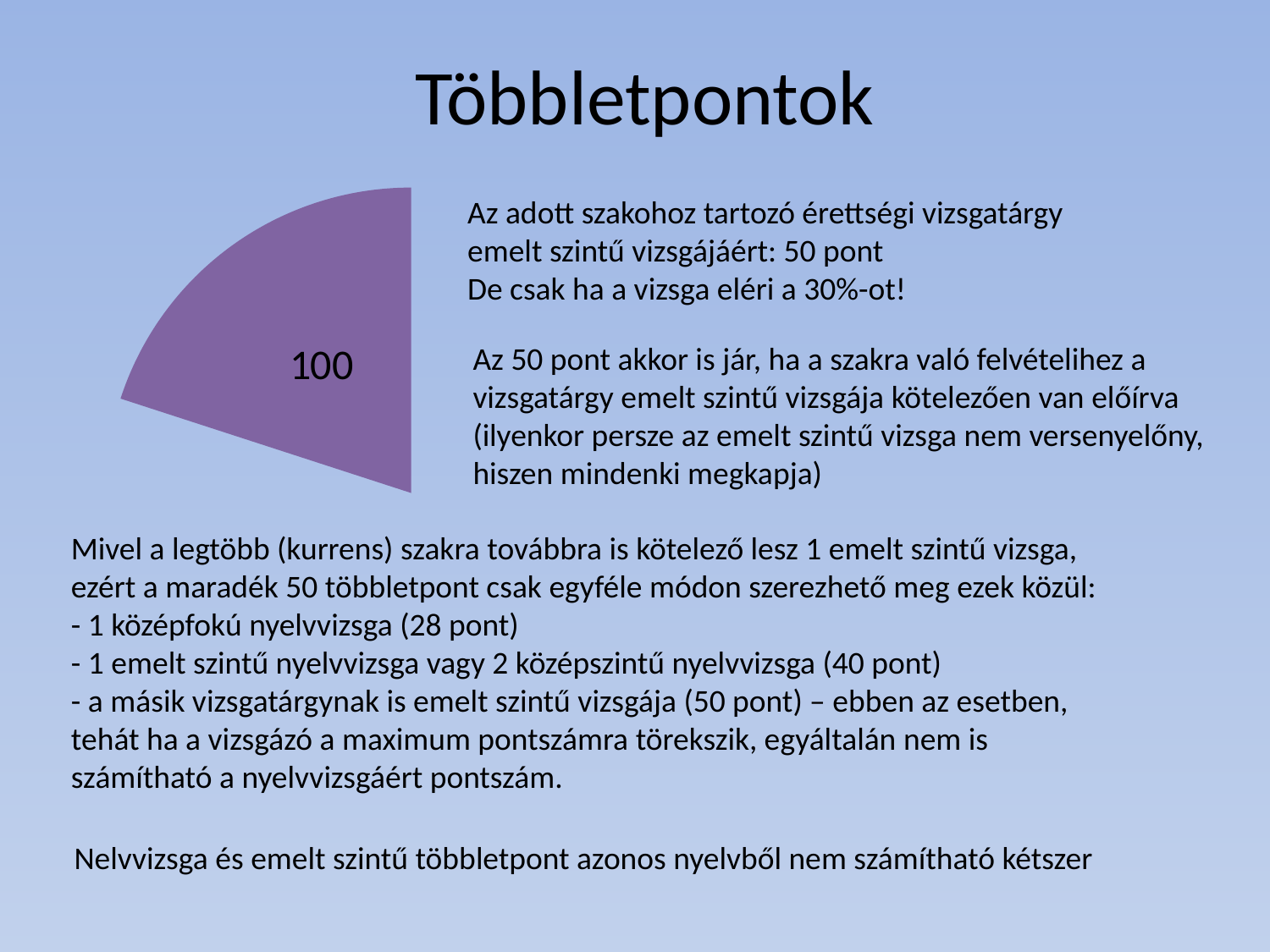
Does the pie chart have a legend? No What colour is the slice of the pie chart? purple What value is printed on the slice of the pie chart? 100 What kind of chart is shown on the slide? pie chart How many slices are labelled in the pie chart? 1